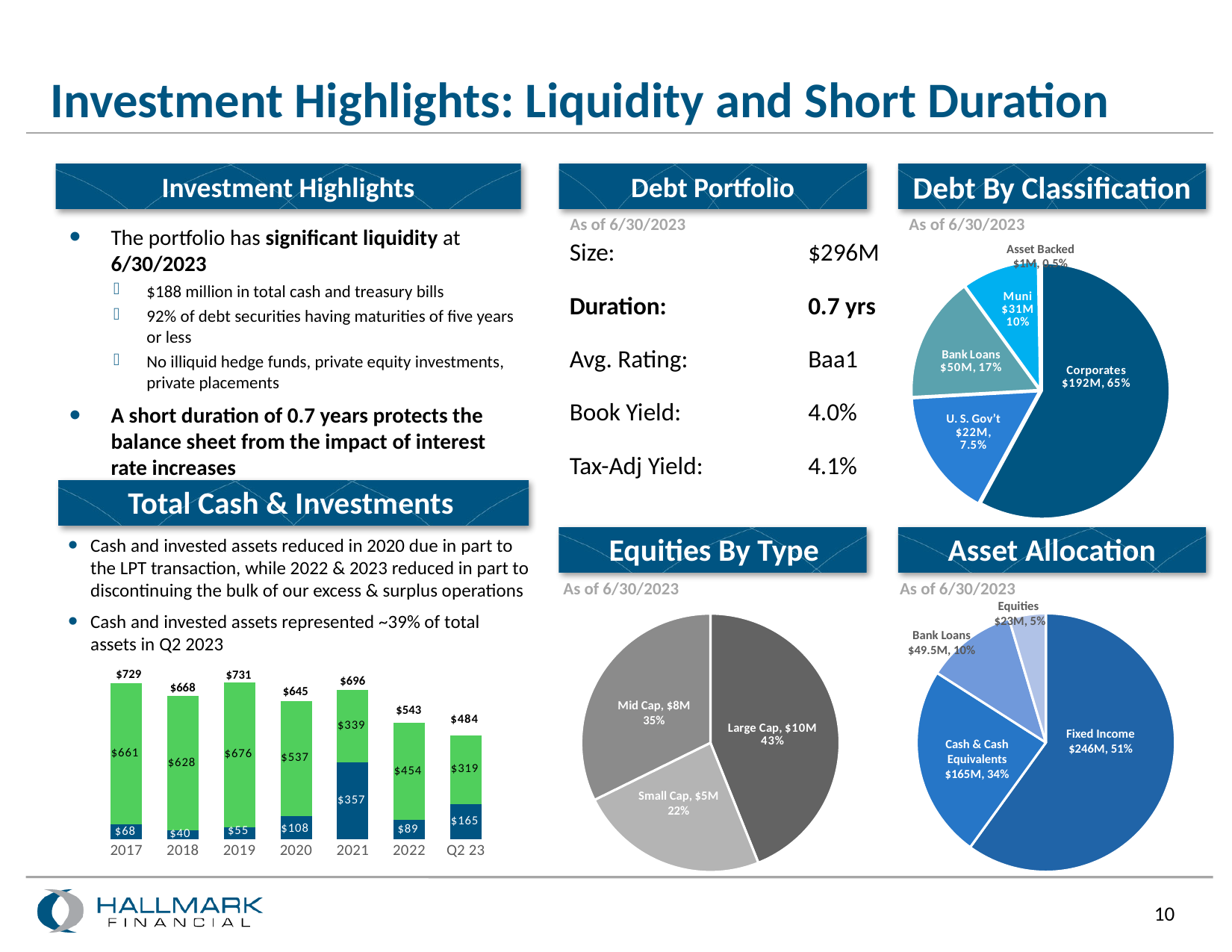
In the Total Cash & Investments chart, what is the value of the blue (bottom) segment for 2021? $357 What kind of chart is the Total Cash & Investments chart? Stacked bar chart In the Total Cash & Investments chart, how many periods are shown on the x axis? 7 In the Total Cash & Investments chart, which year has the lowest total? Q2 23 In the Equities By Type pie chart, how many slices are there? 3 In the Asset Allocation pie chart, what is the value for Cash & Cash Equivalents? $165M, 34% In the Total Cash & Investments chart, what is the total for 2019? $731 In the Debt By Classification pie chart, what share do Corporates represent? 65% In the Equities By Type pie chart, which is larger, Mid Cap or Small Cap? Mid Cap In the Debt By Classification pie chart, what is the value for Bank Loans? $50M In the Total Cash & Investments chart, what is the difference between the 2017 total and the 2018 total? $61 In the Debt By Classification pie chart, which category is the smallest? Asset Backed